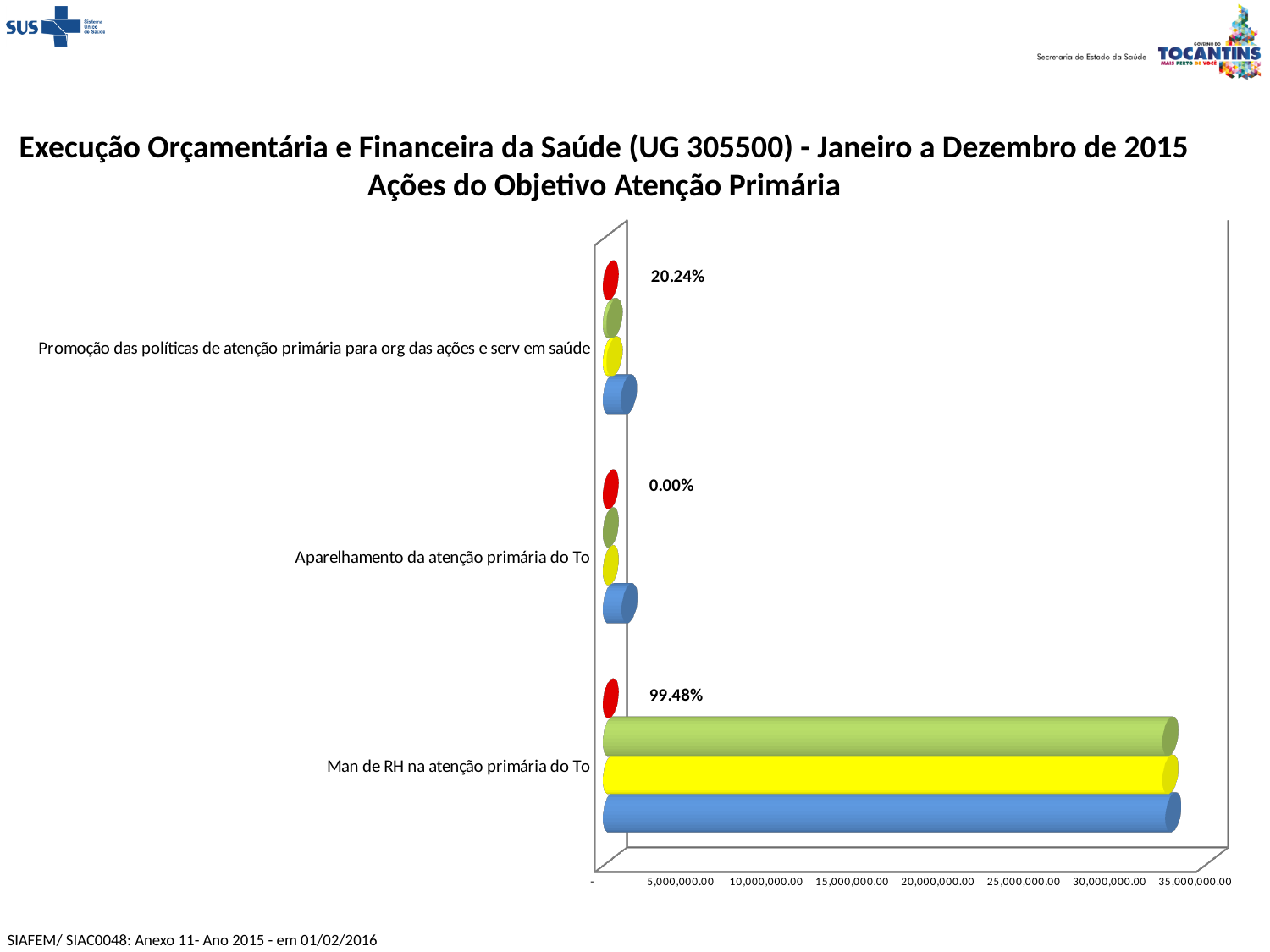
Which category has the highest percentage label? Man de RH na atenção primária do To What kind of chart is shown on the slide? Bar chart What is the difference between the percentage labels for "Man de RH na atenção primária do To" and "Promoção das políticas de atenção primária para org das ações e serv em saúde"? 79.24% Which category has the lowest percentage label? Aparelhamento da atenção primária do To How many categories are shown on the chart? 3 What percentage label is shown for "Man de RH na atenção primária do To"? 99.48% Which category has the larger percentage label: "Promoção das políticas de atenção primária para org das ações e serv em saúde" or "Aparelhamento da atenção primária do To"? Promoção das políticas de atenção primária para org das ações e serv em saúde What percentage label is shown for "Aparelhamento da atenção primária do To"? 0.00% What percentage label is shown for "Promoção das políticas de atenção primária para org das ações e serv em saúde"? 20.24% Is the value of the blue bar for "Man de RH na atenção primária do To" greater or less than 30,000,000.00? greater Is the value of the blue bar for "Aparelhamento da atenção primária do To" greater or less than 5,000,000.00? less What is the second line of the chart title? Ações do Objetivo Atenção Primária